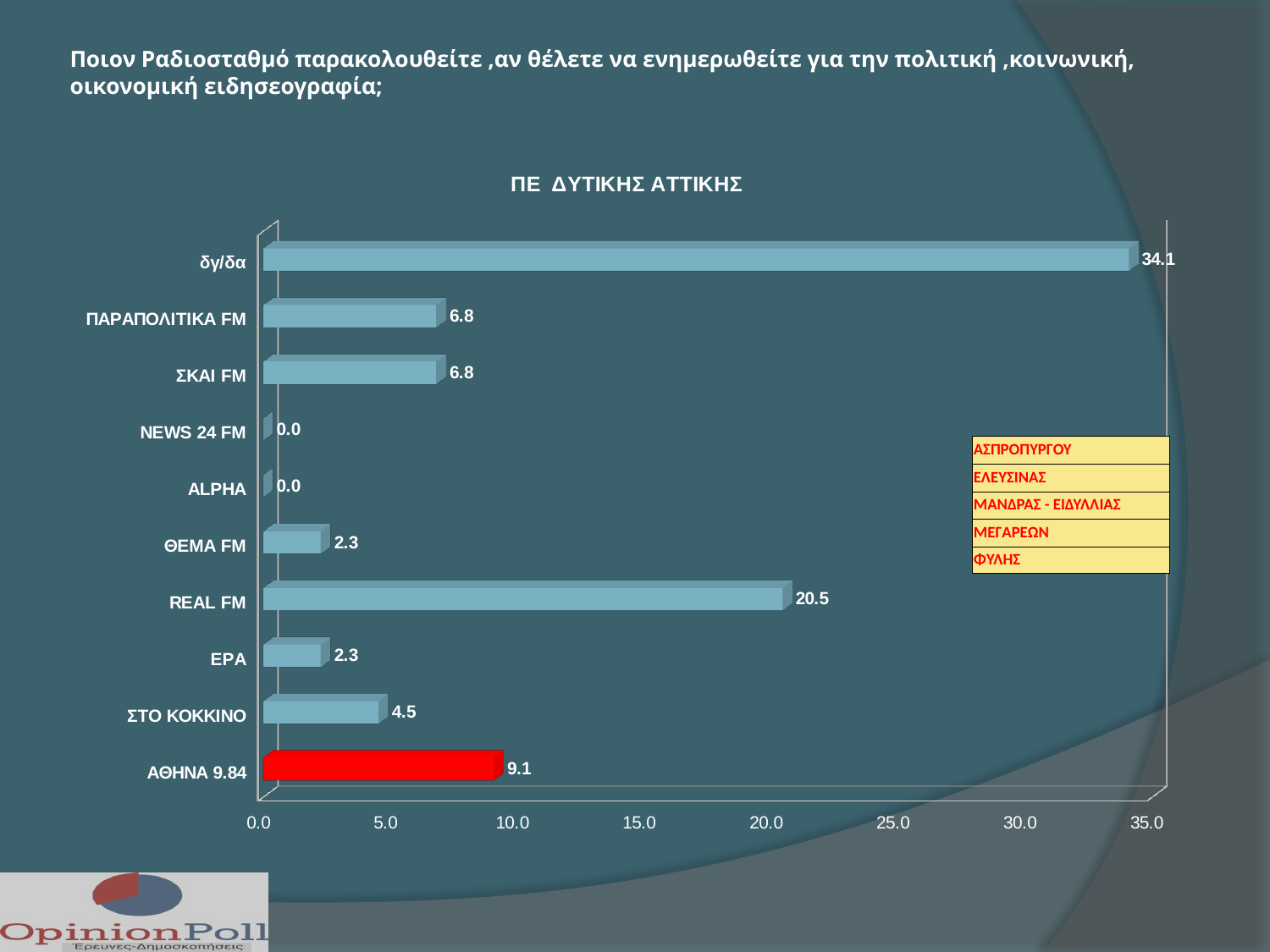
What is the title of the chart? ΠΕ ΔΥΤΙΚΗΣ ΑΤΤΙΚΗΣ Which radio station (excluding δγ/δα) has the highest value? REAL FM What is the value for ΣΤΟ ΚΟΚΚΙΝΟ? 4.5 What kind of chart is shown on the slide? bar chart What is the difference between the values for δγ/δα and REAL FM? 13.6 What is the value for ΑΘΗΝΑ 9.84? 9.1 What is the difference between the values for REAL FM and ΑΘΗΝΑ 9.84? 11.4 Which is larger, the value for ΣΤΟ ΚΟΚΚΙΝΟ or the value for ΘΕΜΑ FM? ΣΤΟ ΚΟΚΚΙΝΟ What is the value for ΣΚΑΙ FM? 6.8 Which category has the highest value? δγ/δα How many categories are shown on the chart? 10 What is the value for REAL FM? 20.5